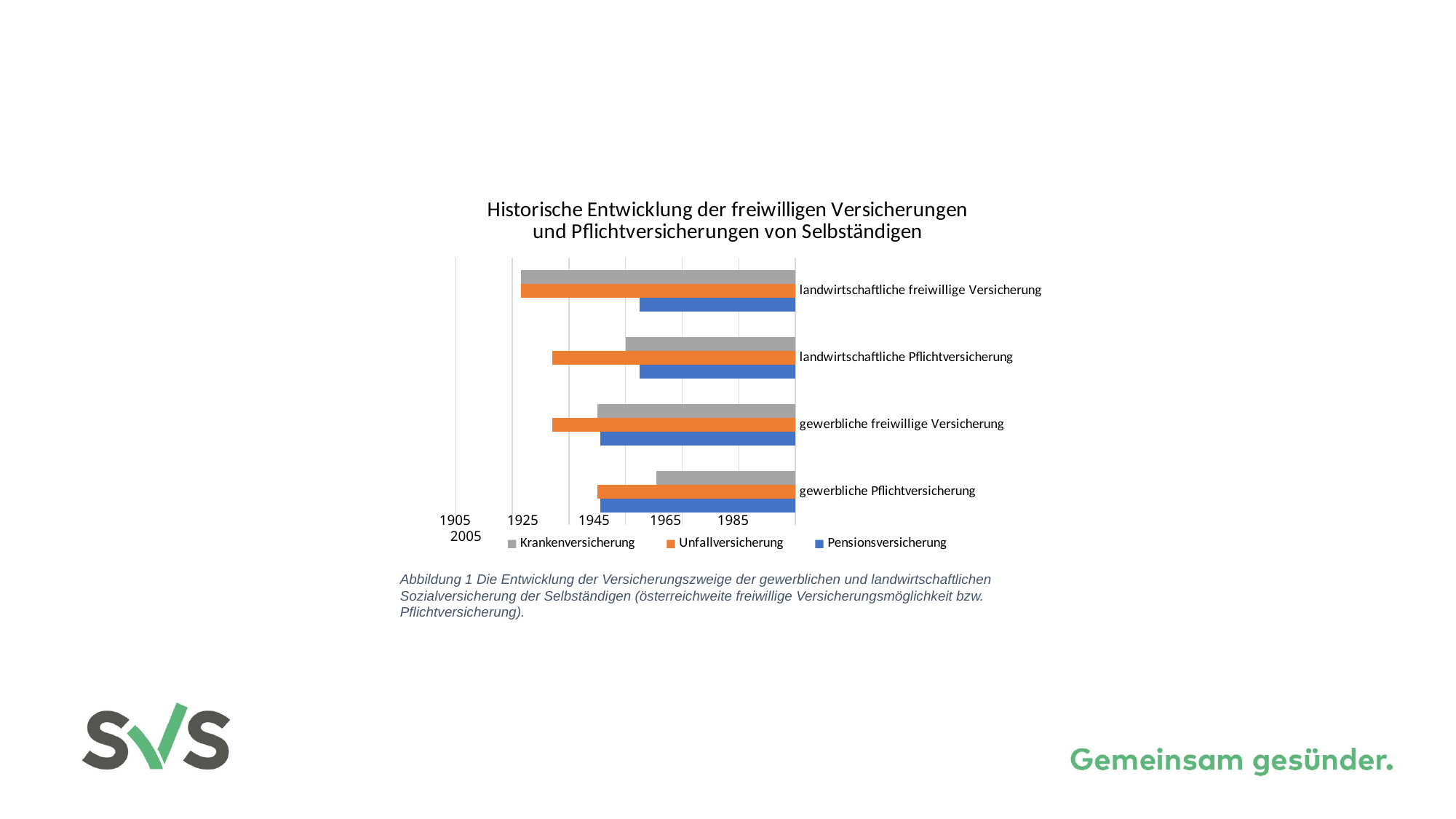
How many series does the chart's legend list? 3 For gewerbliche freiwillige Versicherung, which series has the longest bar? Unfallversicherung For landwirtschaftliche Pflichtversicherung, which series has the longest bar? Unfallversicherung Which category is listed at the top of the chart? landwirtschaftliche freiwillige Versicherung How many categories are shown on the vertical axis of the chart? 4 Which series is shown in orange in the chart? Unfallversicherung What is the title of the chart? Historische Entwicklung der freiwilligen Versicherungen und Pflichtversicherungen von Selbständigen What kind of chart is shown on the slide? Bar chart For gewerbliche Pflichtversicherung, which series has the shortest bar? Krankenversicherung For landwirtschaftliche freiwillige Versicherung, which series has the shortest bar? Pensionsversicherung For gewerbliche Pflichtversicherung, is the Unfallversicherung bar longer or shorter than the Krankenversicherung bar? Longer For landwirtschaftliche Pflichtversicherung, is the Krankenversicherung bar longer or shorter than the Unfallversicherung bar? Shorter